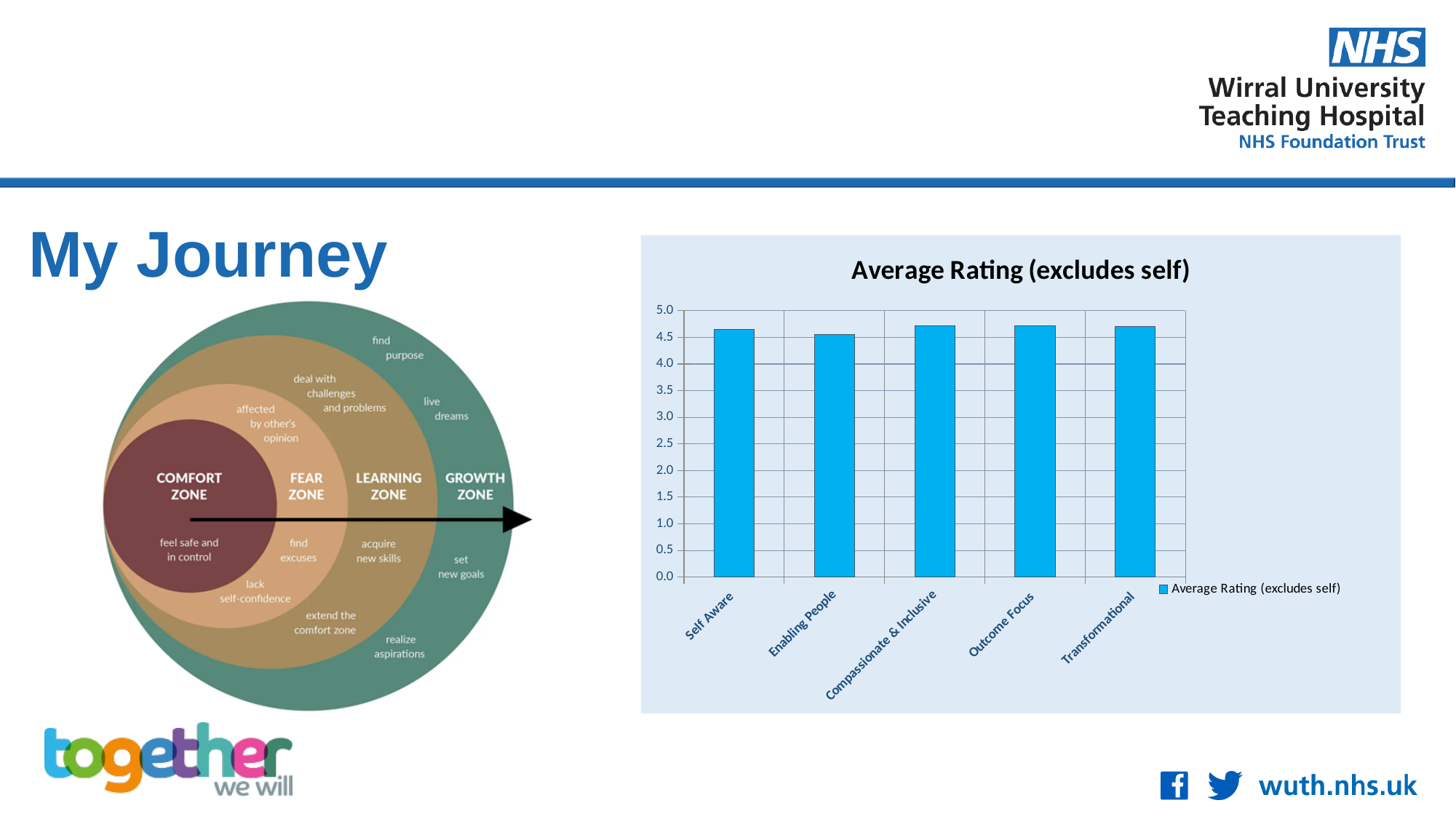
Is the value for Self Aware greater or less than 4.5? greater Is the value for Outcome Focus greater or less than 5.0? less Is the value for Transformational greater or less than 4.5? greater Which is larger, the value for Compassionate & Inclusive or the value for Enabling People? Compassionate & Inclusive What kind of chart is shown on the slide? bar chart What is the highest value shown on the chart's y axis? 5.0 Which category has the lowest average rating in the chart? Enabling People How many categories are plotted on the x axis of the chart? 5 Which is larger, the value for Self Aware or the value for Enabling People? Self Aware How many series does the chart's legend list? 1 What is the title of the chart on the slide? Average Rating (excludes self)